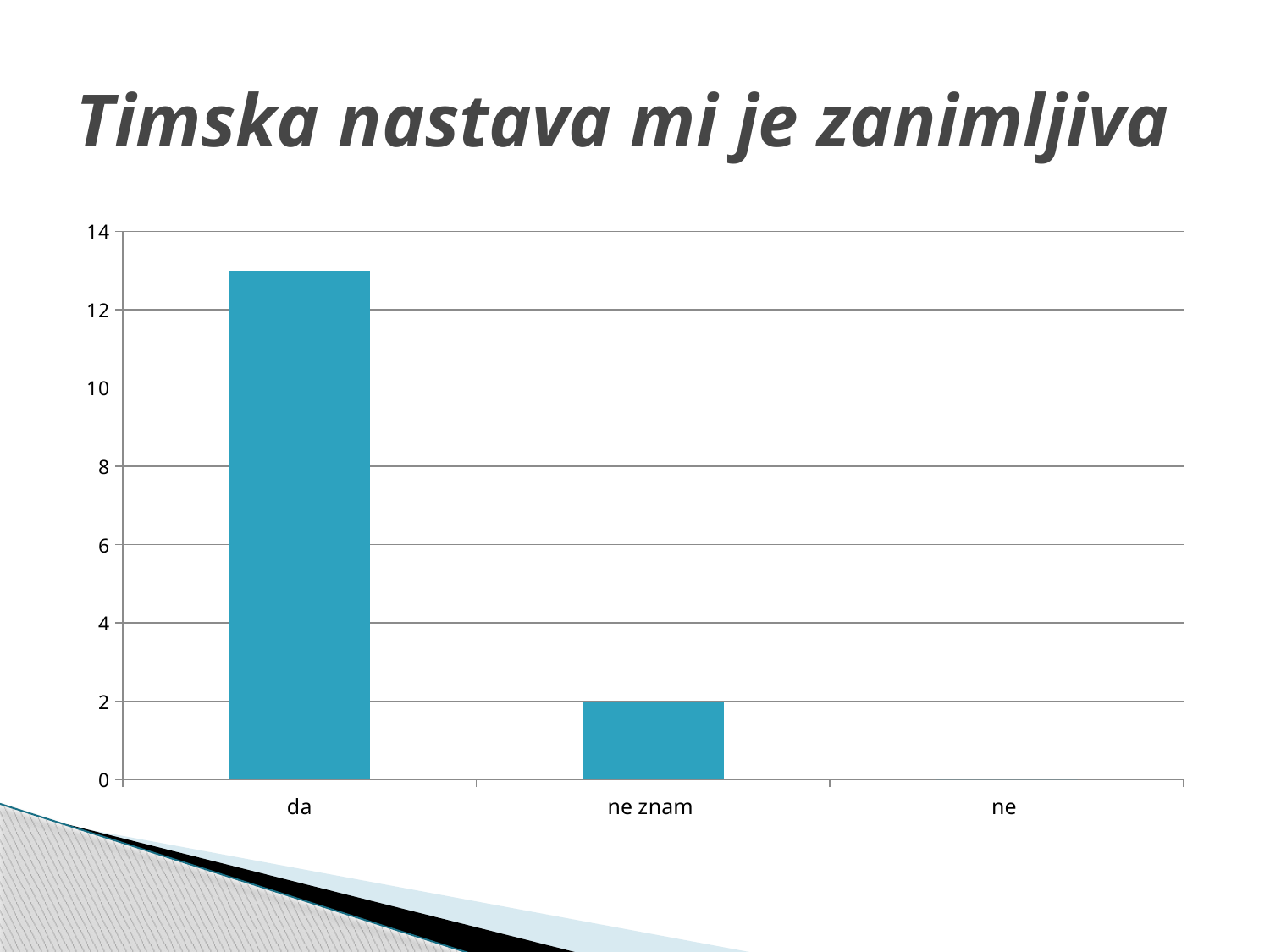
How many categories are shown on the x axis of the chart? 3 Is the value for "da" greater or less than 12? greater What is the value for "ne znam" in the chart? 2 Which is larger, the value for "da" or the value for "ne znam"? da What is the value for "ne" in the chart? 0 Is the value for "da" greater or less than 14? less Do the values rise or fall from left to right along the x axis? fall Which category has the lowest value in the chart? ne What is the difference between the values for "ne znam" and "ne"? 2 What kind of chart is shown on the slide? bar chart What is the title of the slide containing the chart? Timska nastava mi je zanimljiva Which category has the highest value in the chart? da